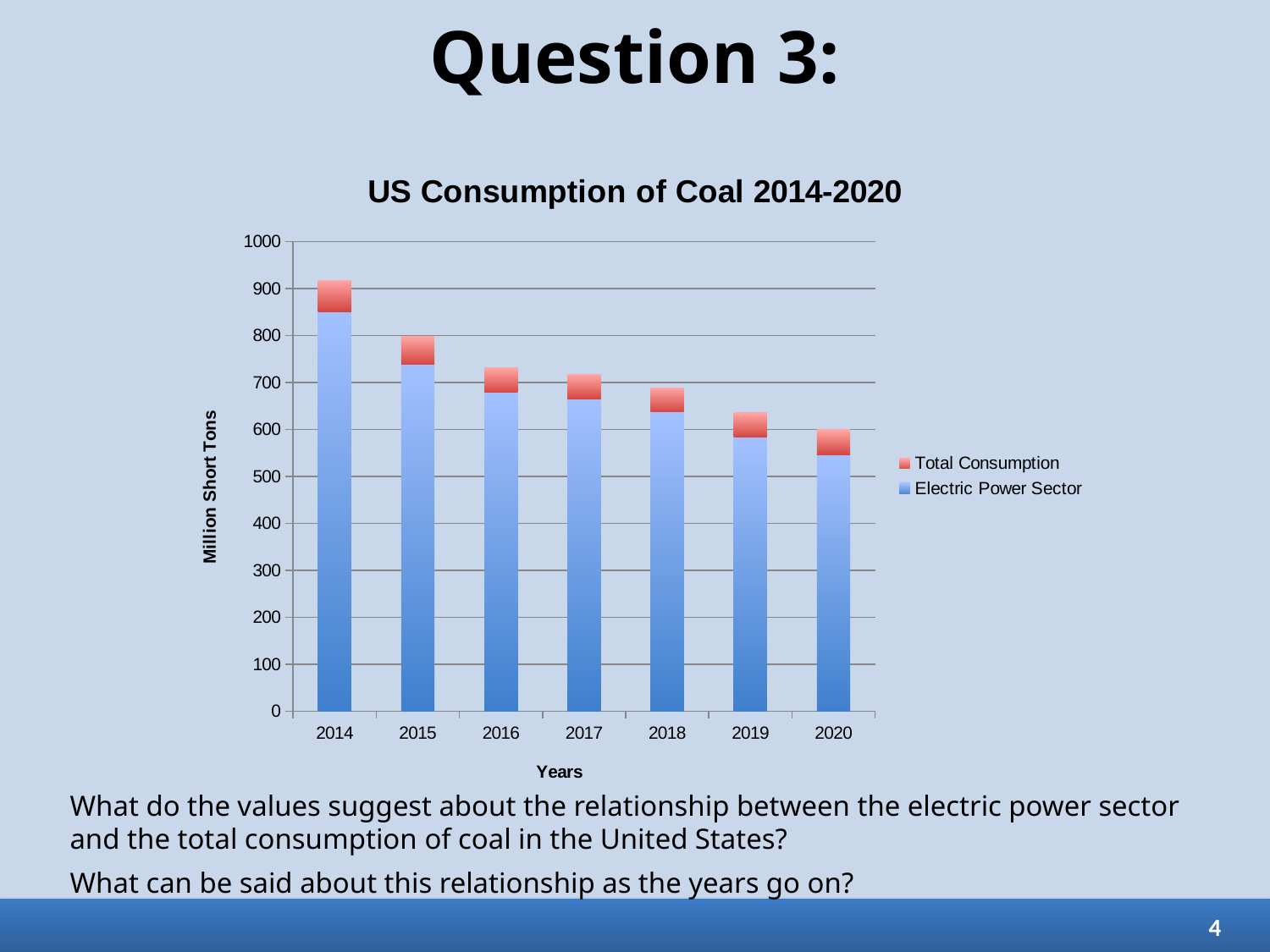
Is the Electric Power Sector value for 2018 greater or less than 700? less Which year has the tallest bar in the chart? 2014 What kind of chart is shown on the slide? bar chart Which year has the shortest bar in the chart? 2020 Is the Electric Power Sector value for 2014 greater or less than 800? greater How many years are shown on the x axis of the chart? 7 Is the Electric Power Sector value for 2015 greater or less than 700? greater How many series does the chart's legend list? 2 What is the label on the chart's vertical axis? Million Short Tons What is the title of the chart? US Consumption of Coal 2014-2020 Do the bars rise or fall from 2014 to 2020? fall